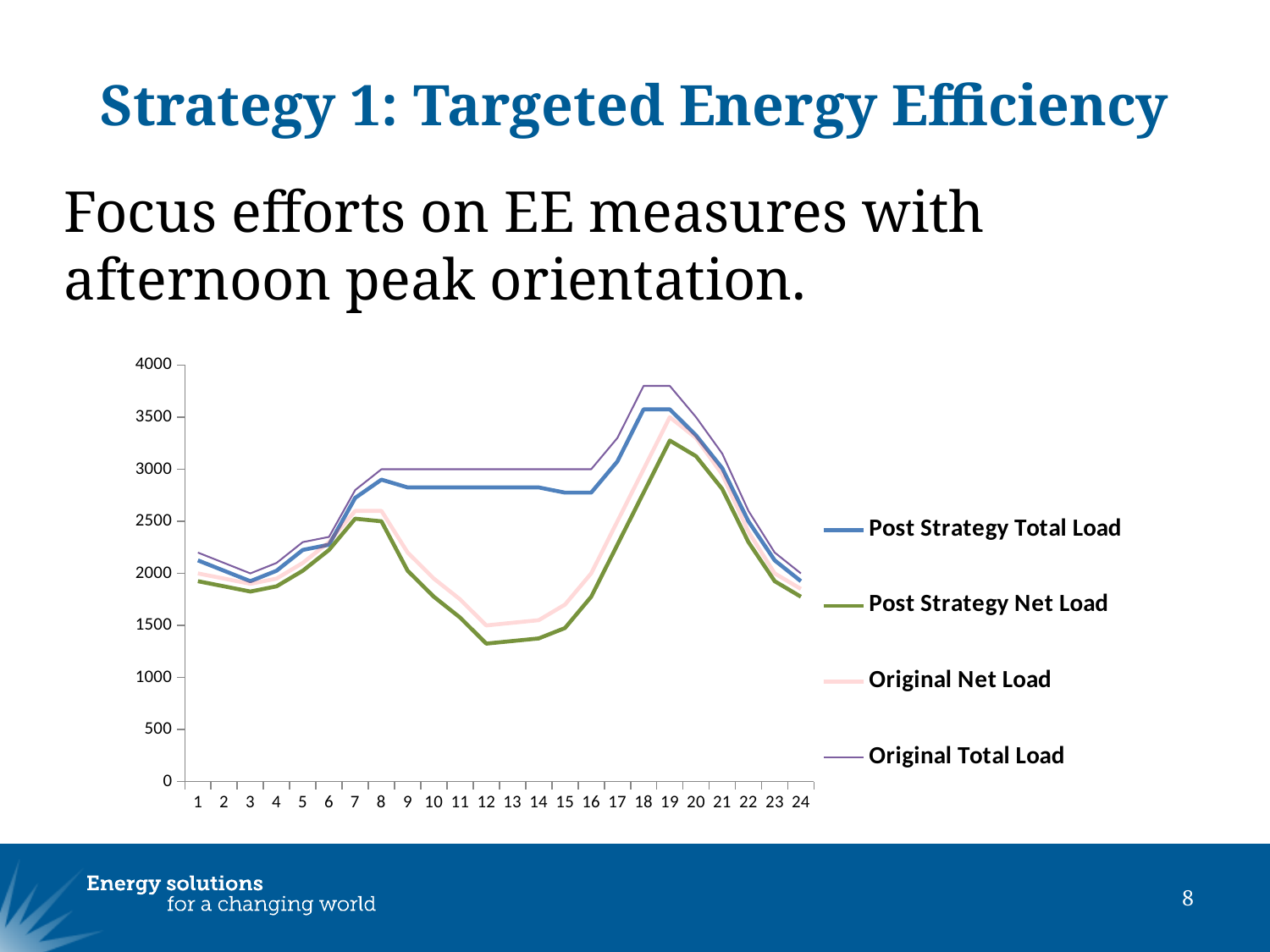
Which series is drawn in green? Post Strategy Net Load Is the value of Original Total Load at hour 3 greater or less than 2500? less Is the value of Post Strategy Total Load at hour 10 greater or less than 2500? greater What kind of chart is shown on the slide? line chart At which hour does Post Strategy Net Load reach its lowest value? 12 Is the value of Original Total Load at hour 18 greater or less than 3500? greater Do the values of Post Strategy Total Load rise or fall from hour 19 to hour 24? fall How many points are plotted along the x axis for each series? 24 At which hour does Post Strategy Net Load reach its highest value? 19 How many series does the chart's legend list? 4 At hour 12, which is larger: Original Net Load or Post Strategy Net Load? Original Net Load